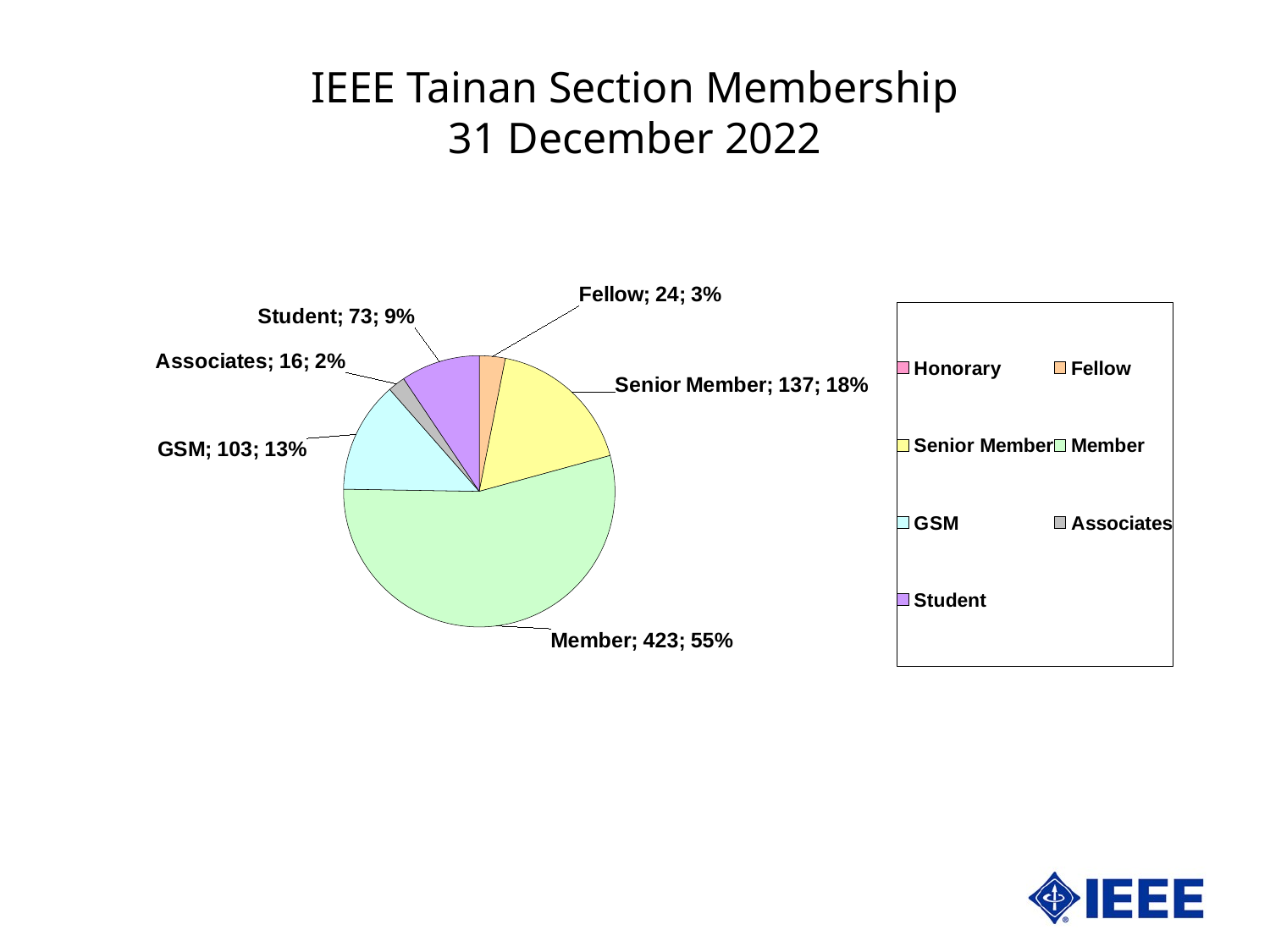
Which labelled category has the smallest slice of the pie? Associates Which category has the largest slice of the pie? Member How many members are in the Member category? 423 What is the title of the slide containing the chart? IEEE Tainan Section Membership 31 December 2022 Which is larger, the Fellow count or the Associates count? Fellow What colour is the Member slice of the pie? light green How many entries does the legend list? 7 What share of the pie is the Student slice? 9% What is the difference between the Senior Member count and the GSM count? 34 What percentage of the pie does the Senior Member slice represent? 18% What kind of chart is shown on the slide? pie chart How many members are in the GSM category? 103